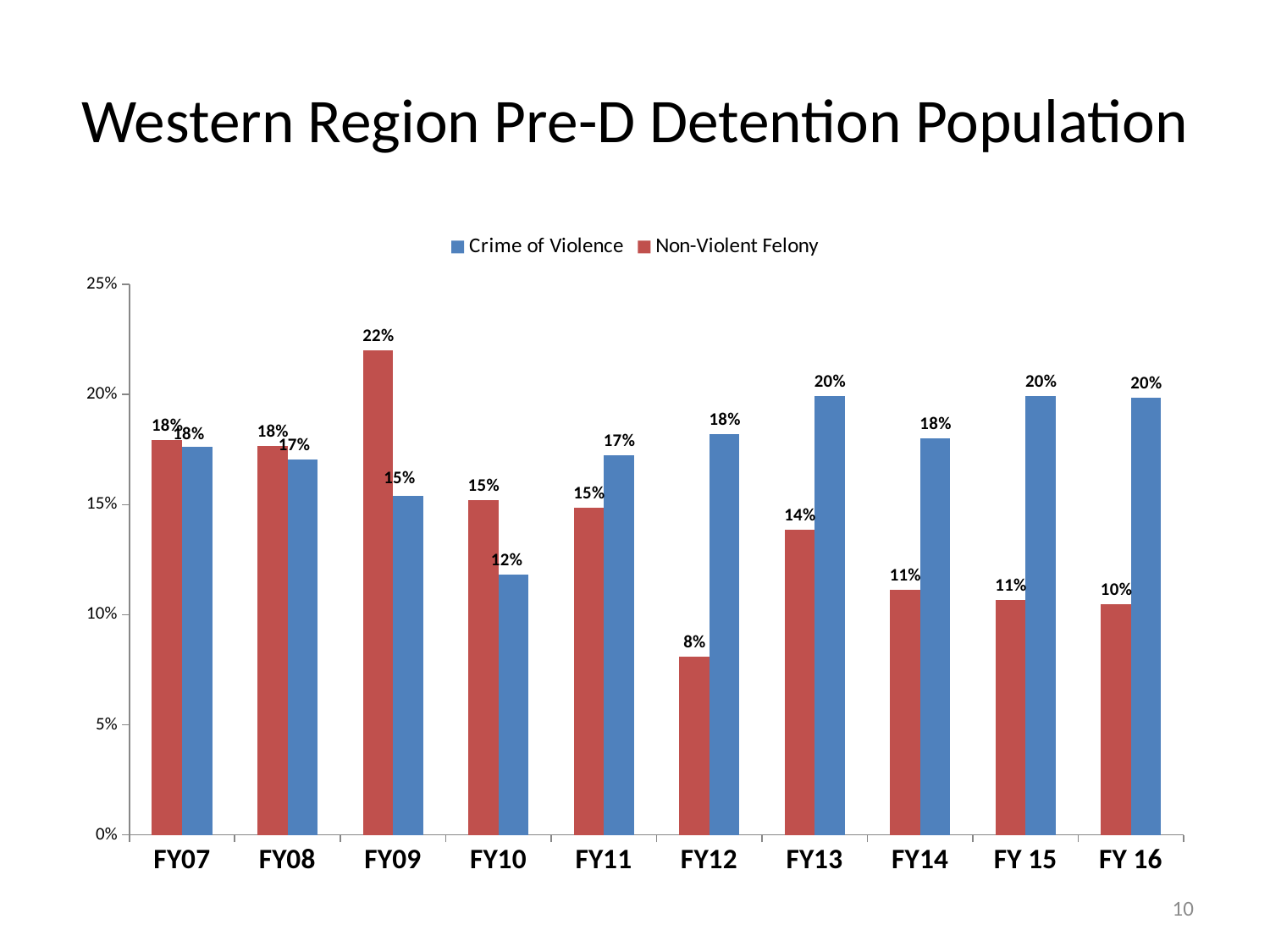
What is the difference between the Crime of Violence and Non-Violent Felony values in FY12? 10% What is the Non-Violent Felony value for FY09? 22% In which fiscal year is the Non-Violent Felony value highest? FY09 In which fiscal year is the Non-Violent Felony value lowest? FY12 What is the Non-Violent Felony value for FY12? 8% How many series does the legend list? 2 What is the Crime of Violence value for FY10? 12% How many fiscal years are shown on the x axis? 10 What is the Crime of Violence value for FY 16? 20% What kind of chart is shown on the slide? Bar chart In which fiscal year is the Crime of Violence value lowest? FY10 In FY13, which series has the larger value, Crime of Violence or Non-Violent Felony? Crime of Violence